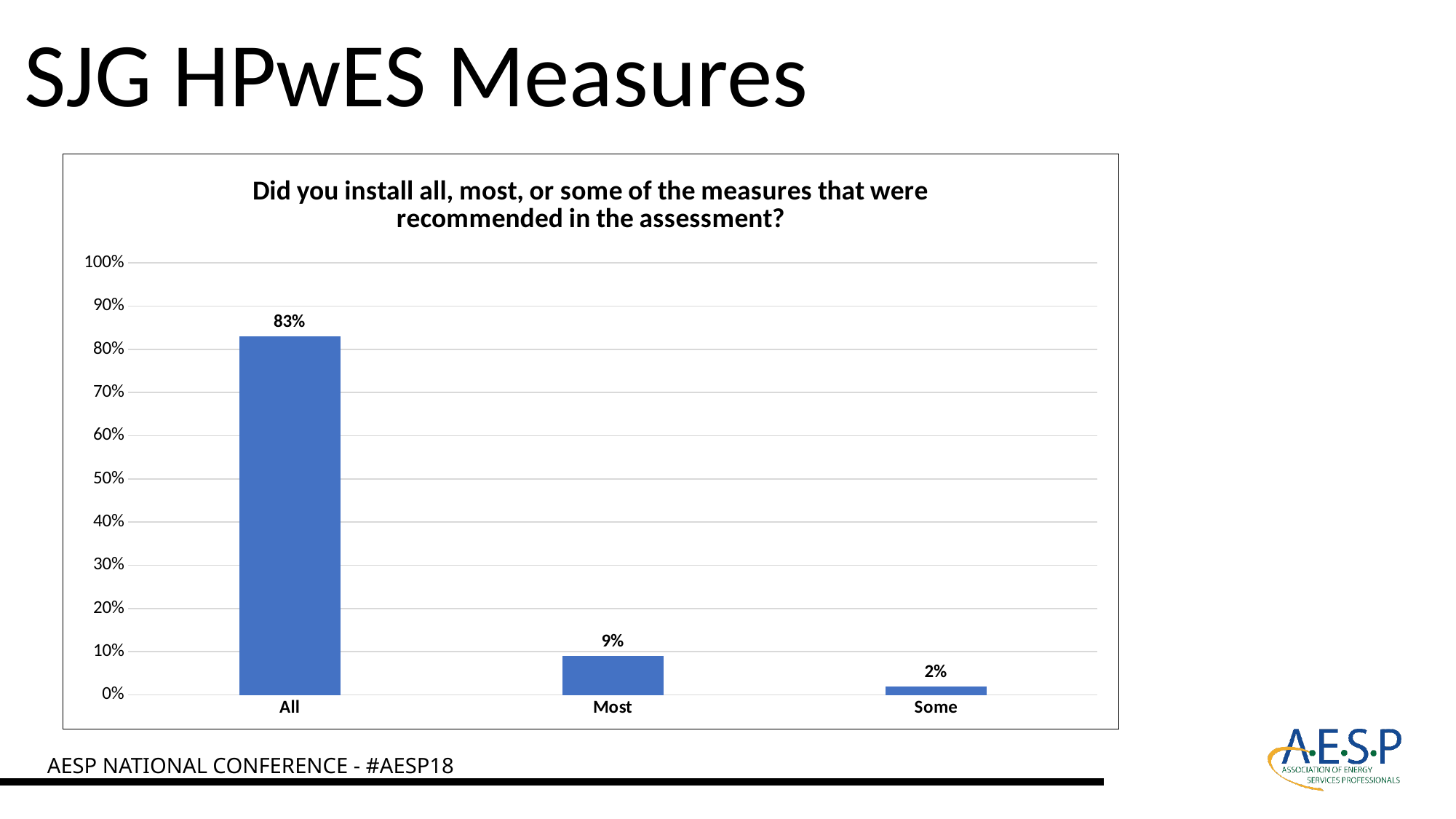
Which category has the highest value? All Which is larger, the value for 'Most' or the value for 'Some'? Most What kind of chart is shown on the slide? Bar chart What is the value shown for the 'Most' category? 9% What is the difference between the values for 'Most' and 'Some'? 7% Which category has the lowest value? Some What percentage of respondents installed all of the recommended measures? 83% What is the difference between the values for 'All' and 'Most'? 74% What is the value shown for the 'Some' category? 2% What is the title of the chart? Did you install all, most, or some of the measures that were recommended in the assessment? How many categories are shown on the x axis? 3 Is the value for 'All' greater or less than 80%? greater